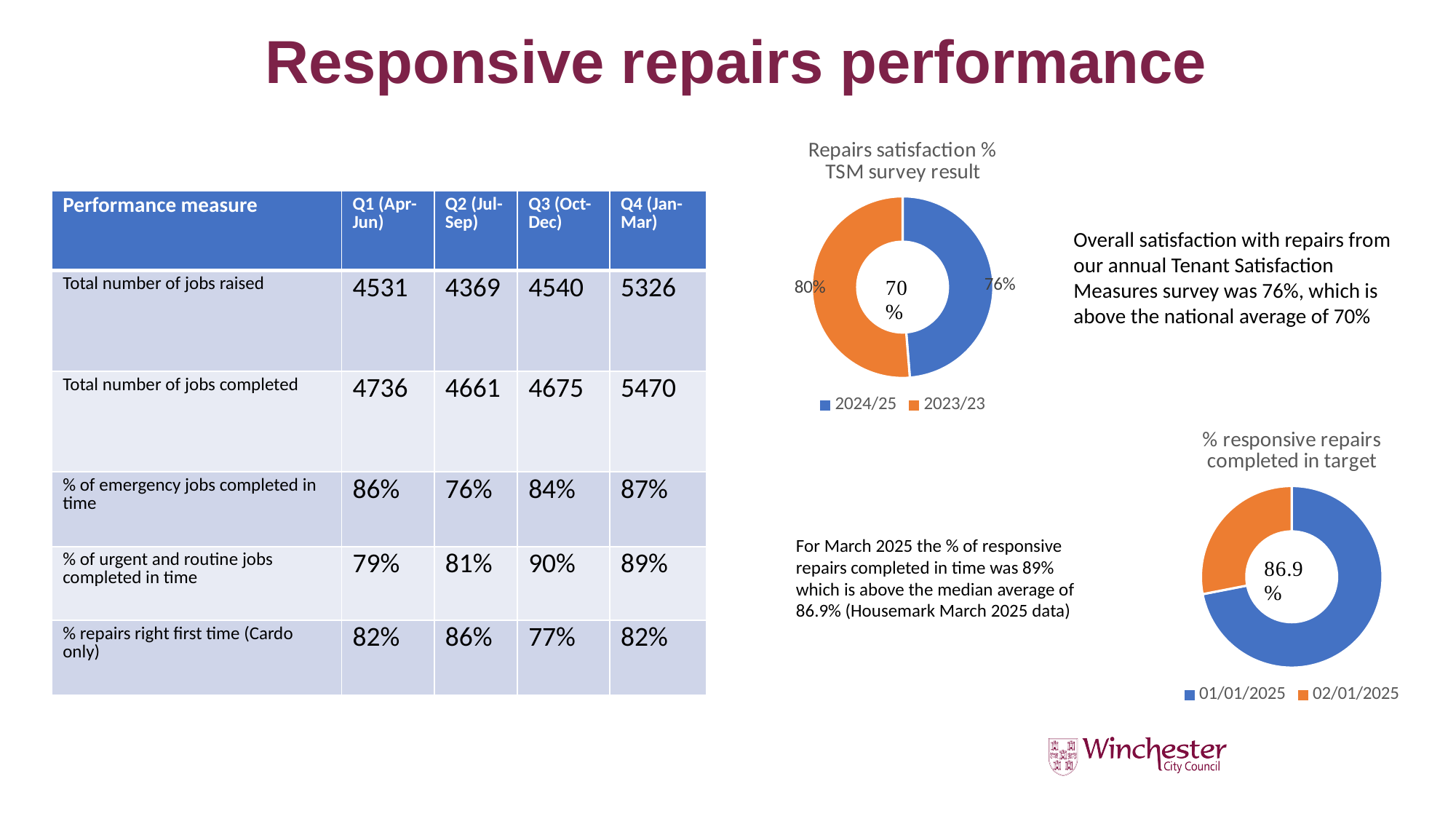
How many series does the legend of the 'Repairs satisfaction % TSM survey result' chart list? 2 What type of chart is the 'Repairs satisfaction % TSM survey result' chart? Doughnut chart In the 'Repairs satisfaction % TSM survey result' chart, what is the difference between the 2023/23 value and the 2024/25 value? 4% How many doughnut charts are shown on the slide? 2 In the '% responsive repairs completed in target' chart, which series takes the larger share, 01/01/2025 or 02/01/2025? 01/01/2025 How many series does the legend of the '% responsive repairs completed in target' chart list? 2 What type of chart is the '% responsive repairs completed in target' chart? Doughnut chart In the 'Repairs satisfaction % TSM survey result' chart, what value is shown for 2024/25? 76% What number is printed in the centre of the 'Repairs satisfaction % TSM survey result' doughnut chart? 70% What number is printed in the centre of the '% responsive repairs completed in target' doughnut chart? 86.9% In the 'Repairs satisfaction % TSM survey result' chart, what value is shown for 2023/23? 80% In the 'Repairs satisfaction % TSM survey result' chart, which series has the higher value, 2024/25 or 2023/23? 2023/23